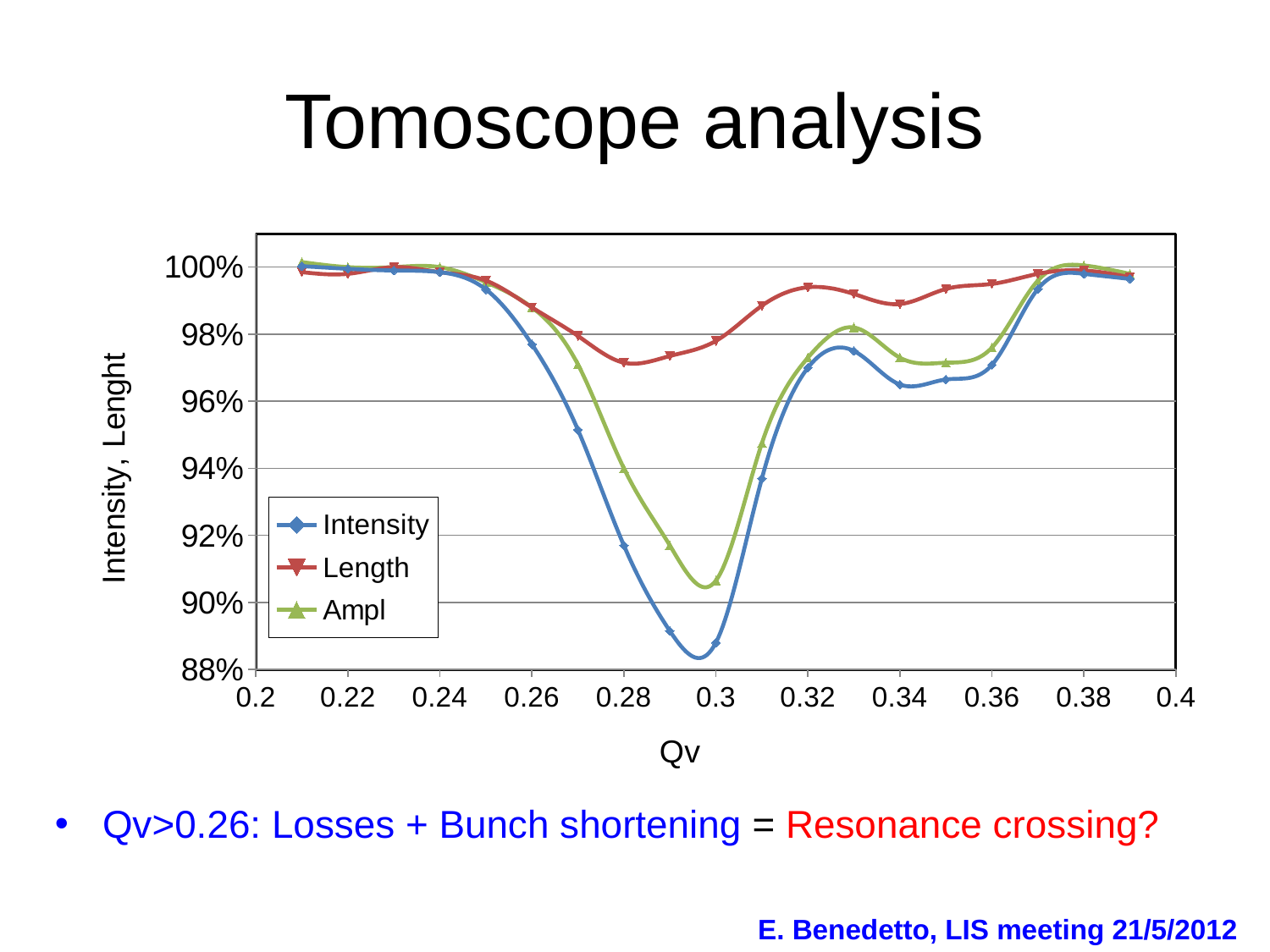
Is the Length value at Qv = 0.28 greater or less than 96%? greater Does the Intensity series rise or fall as Qv goes from 0.24 to 0.3? fall At Qv = 0.3, which series has the higher value, Intensity or Length? Length What is the title of the x axis? Qv Is the Ampl value at Qv = 0.3 greater or less than 92%? less Is the Intensity value at Qv = 0.3 greater or less than 90%? less What kind of chart is shown on the slide? line chart Does the Ampl series rise or fall as Qv goes from 0.3 to 0.32? rise How many series does the legend list? 3 Which series reaches the lowest value on the chart? Intensity What are the series names listed in the legend? Intensity, Length, Ampl At Qv = 0.34, which series has the higher value, Ampl or Intensity? Ampl